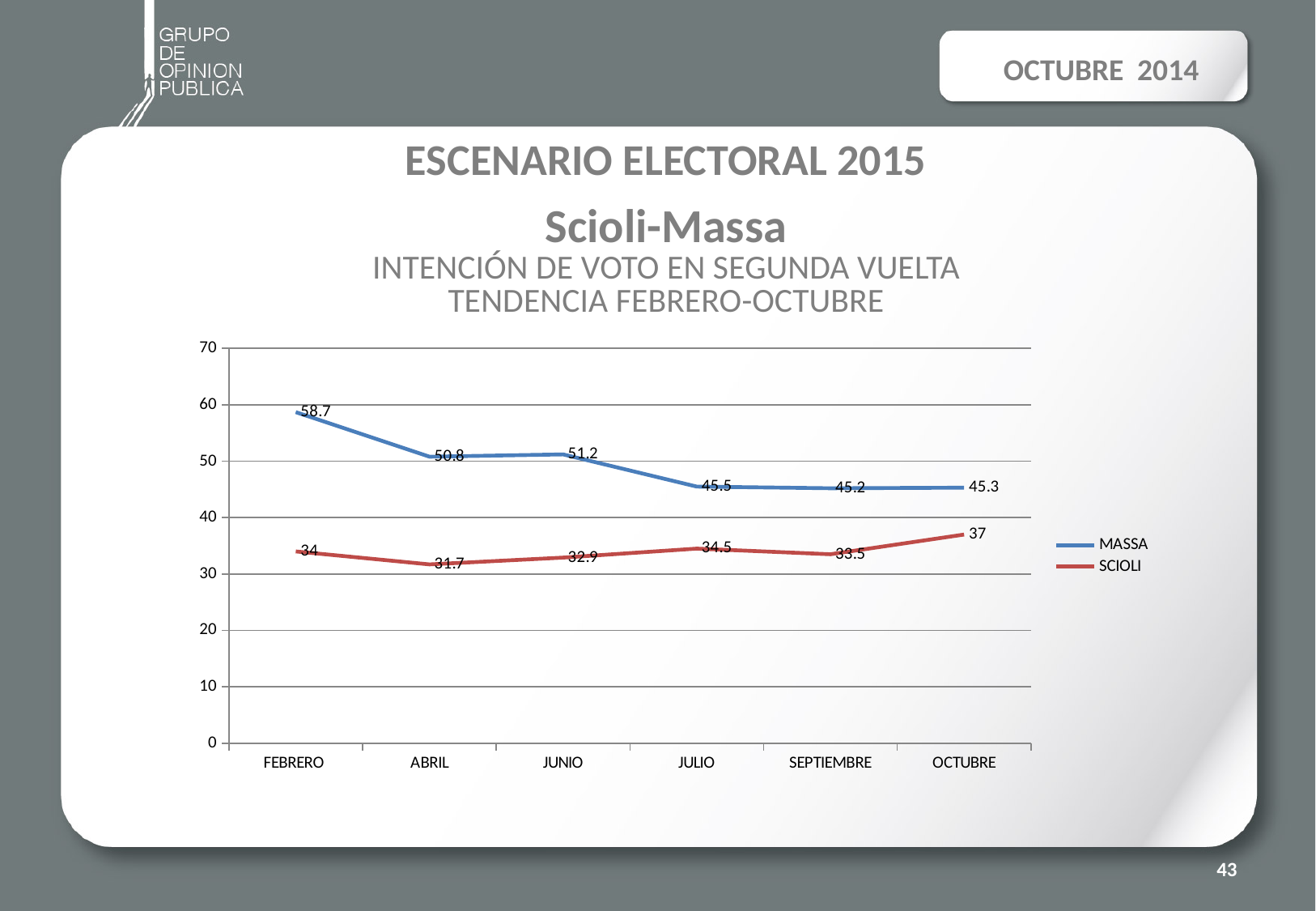
What kind of chart is shown on the slide? Line chart Which colour is used for the SCIOLI line? Red How many series does the legend list? 2 In which month is the SCIOLI value lowest? ABRIL In which month is the MASSA value highest? FEBRERO What is the value for MASSA in FEBRERO? 58.7 Does the MASSA line generally rise or fall from FEBRERO to OCTUBRE? Fall Which series has the larger value in SEPTIEMBRE, MASSA or SCIOLI? MASSA How many months are shown on the x axis? 6 What is the value for SCIOLI in OCTUBRE? 37 What is the difference between MASSA and SCIOLI in JULIO? 11 What is the value for SCIOLI in ABRIL? 31.7